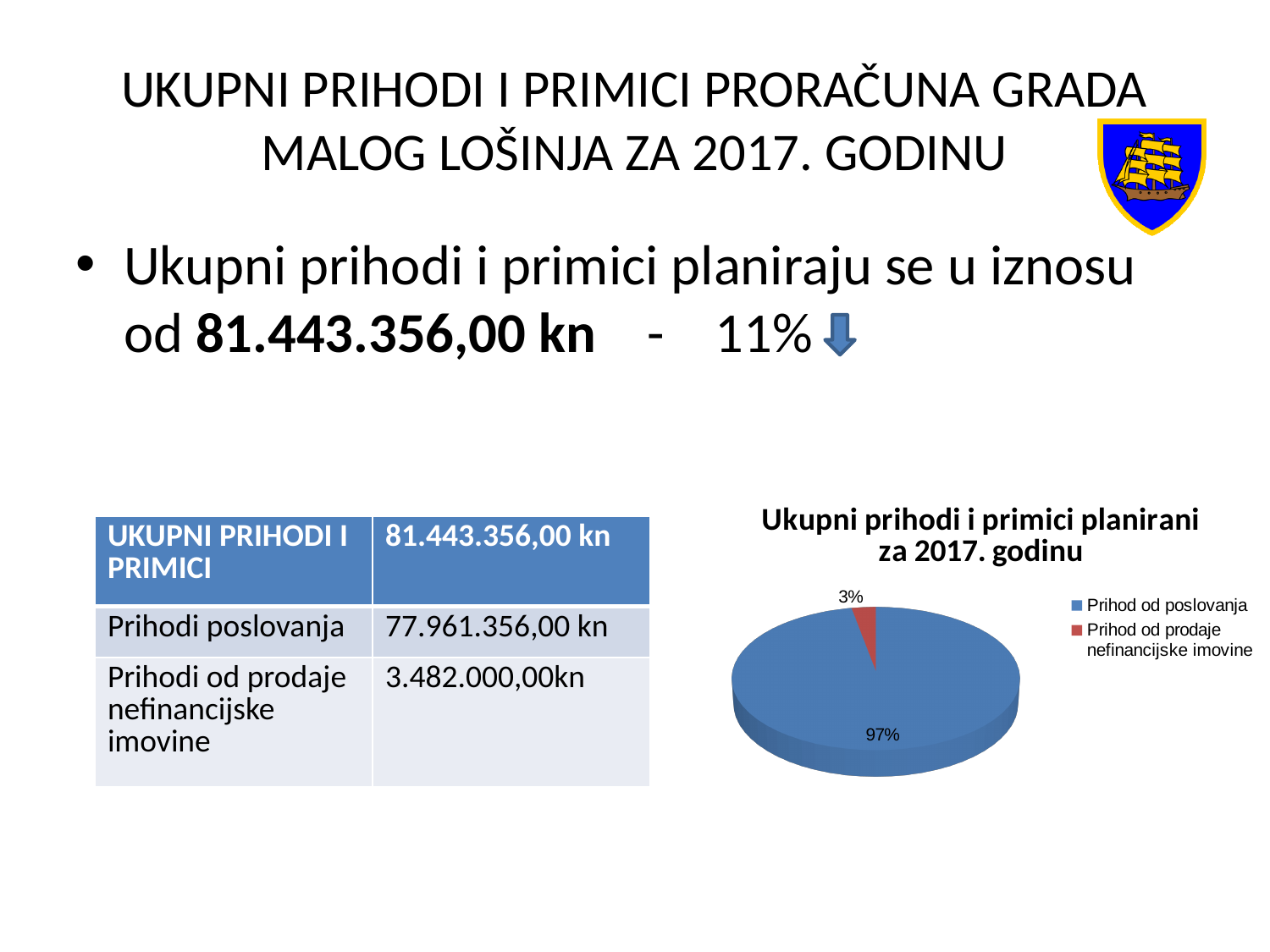
What is the difference in percentage points between the Prihod od poslovanja slice and the Prihod od prodaje nefinancijske imovine slice? 94 Which category has the smallest slice of the pie? Prihod od prodaje nefinancijske imovine How many slices does the pie chart have? 2 Which is larger, the slice for Prihod od poslovanja or the slice for Prihod od prodaje nefinancijske imovine? Prihod od poslovanja What kind of chart is shown on the slide? pie chart What colour is the slice for Prihod od prodaje nefinancijske imovine? red What is the title of the chart? Ukupni prihodi i primici planirani za 2017. godinu What share of the pie does Prihod od poslovanja represent? 97% What share of the pie does Prihod od prodaje nefinancijske imovine represent? 3% Which category has the largest slice of the pie? Prihod od poslovanja How many entries does the chart legend list? 2